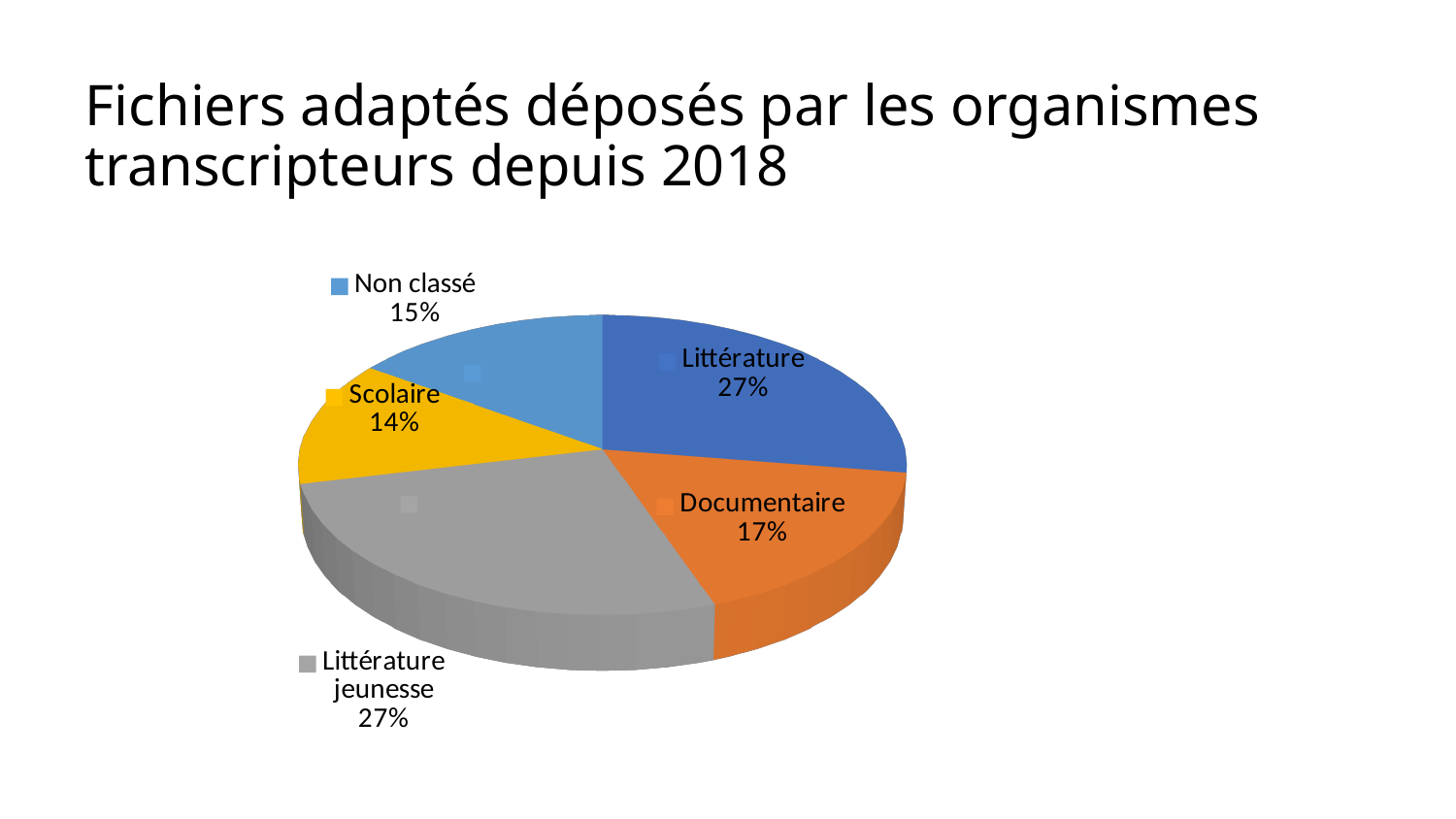
What percentage is shown for Non classé? 15% Which category has the smallest share of the pie? Scolaire What is the difference in percentage points between Littérature and Documentaire? 10 What kind of chart is shown on the slide? Pie chart What percentage is shown for Scolaire? 14% What share of the pie does Littérature jeunesse represent? 27% What is the title of the slide? Fichiers adaptés déposés par les organismes transcripteurs depuis 2018 What is the difference in percentage points between Non classé and Scolaire? 1 What share of the pie does Littérature represent? 27% Which is larger, the share for Documentaire or the share for Scolaire? Documentaire What percentage is shown for Documentaire? 17% How many categories are shown in the pie chart? 5